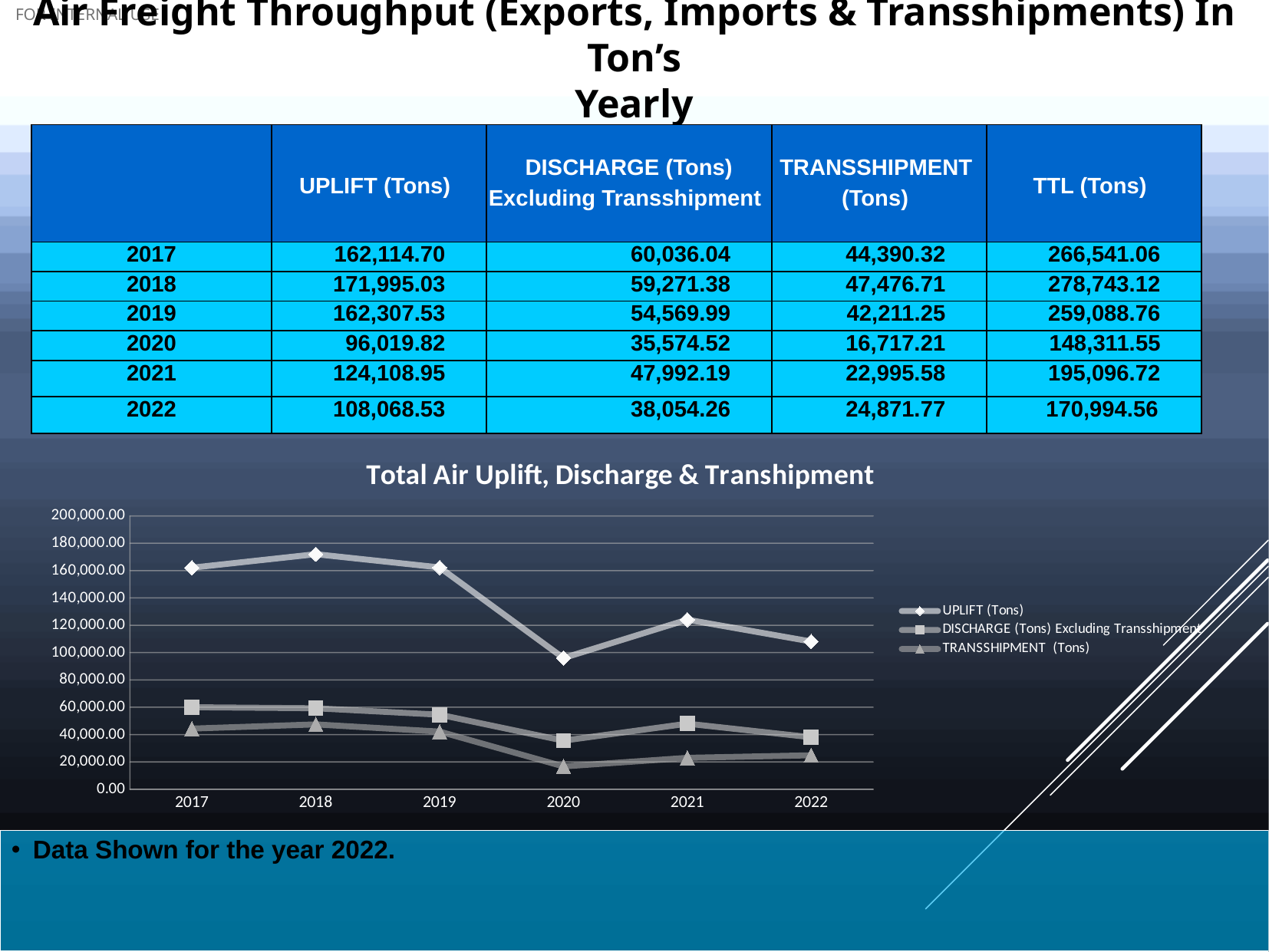
What is the UPLIFT (Tons) value for 2018? 171,995.03 What is the TRANSSHIPMENT (Tons) value for 2020? 16,717.21 What kind of chart is shown on the slide? line chart How many years are plotted along the x axis of the chart? 6 In which year is the UPLIFT (Tons) series at its highest? 2018 Is the UPLIFT (Tons) value for 2021 greater or less than 140,000.00? less In which year is the UPLIFT (Tons) series at its lowest? 2020 In which year is the TRANSSHIPMENT (Tons) series at its lowest? 2020 Which is larger in 2021, DISCHARGE (Tons) Excluding Transshipment or TRANSSHIPMENT (Tons)? DISCHARGE (Tons) Excluding Transshipment What is the title of the chart? Total Air Uplift, Discharge & Transhipment How many series does the chart legend list? 3 Is the UPLIFT (Tons) value for 2017 greater or less than 140,000.00? greater